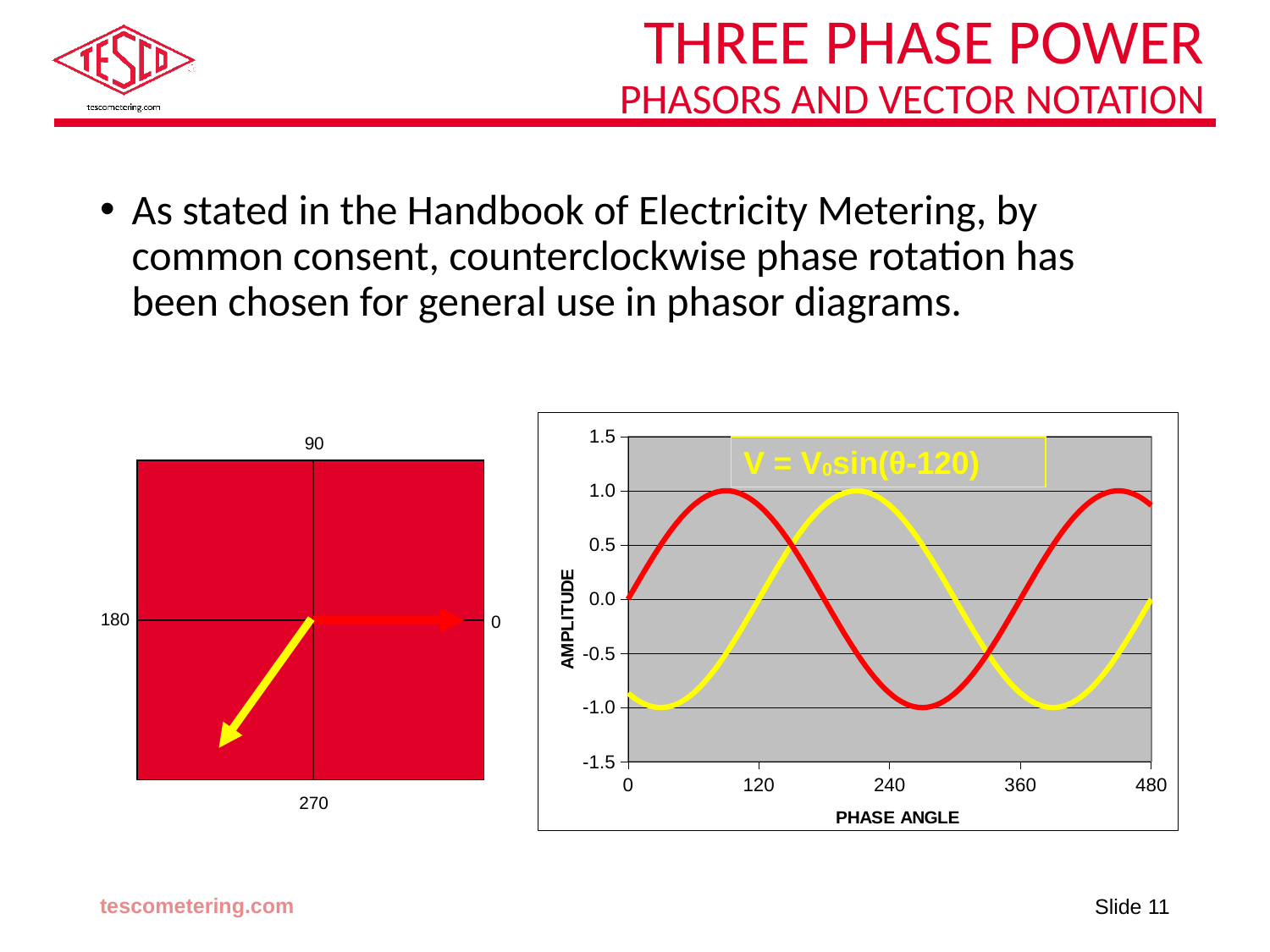
In the right-hand chart, how many tick labels are shown on the horizontal axis? 5 In the right-hand chart, what is the largest phase angle tick shown on the horizontal axis? 480 In the right-hand chart, which curve has the higher amplitude at phase angle 240, the red or the yellow? yellow In the right-hand chart, what is the title of the horizontal axis? PHASE ANGLE In the right-hand chart, does the red curve rise or fall as the phase angle goes from 0 to 90? rise What kind of chart is shown on the right side of the slide? line chart In the right-hand chart, is the amplitude of the yellow curve at phase angle 0 greater or less than -0.5? less In the right-hand chart, how many curves are plotted? 2 In the right-hand chart, what is the amplitude of the yellow curve at phase angle 120? 0.0 In the right-hand chart, what is the amplitude of the red curve at phase angle 0? 0.0 In the right-hand chart, is the amplitude of the red curve at phase angle 120 greater or less than 0.5? greater In the right-hand chart, what is the title of the vertical axis? AMPLITUDE